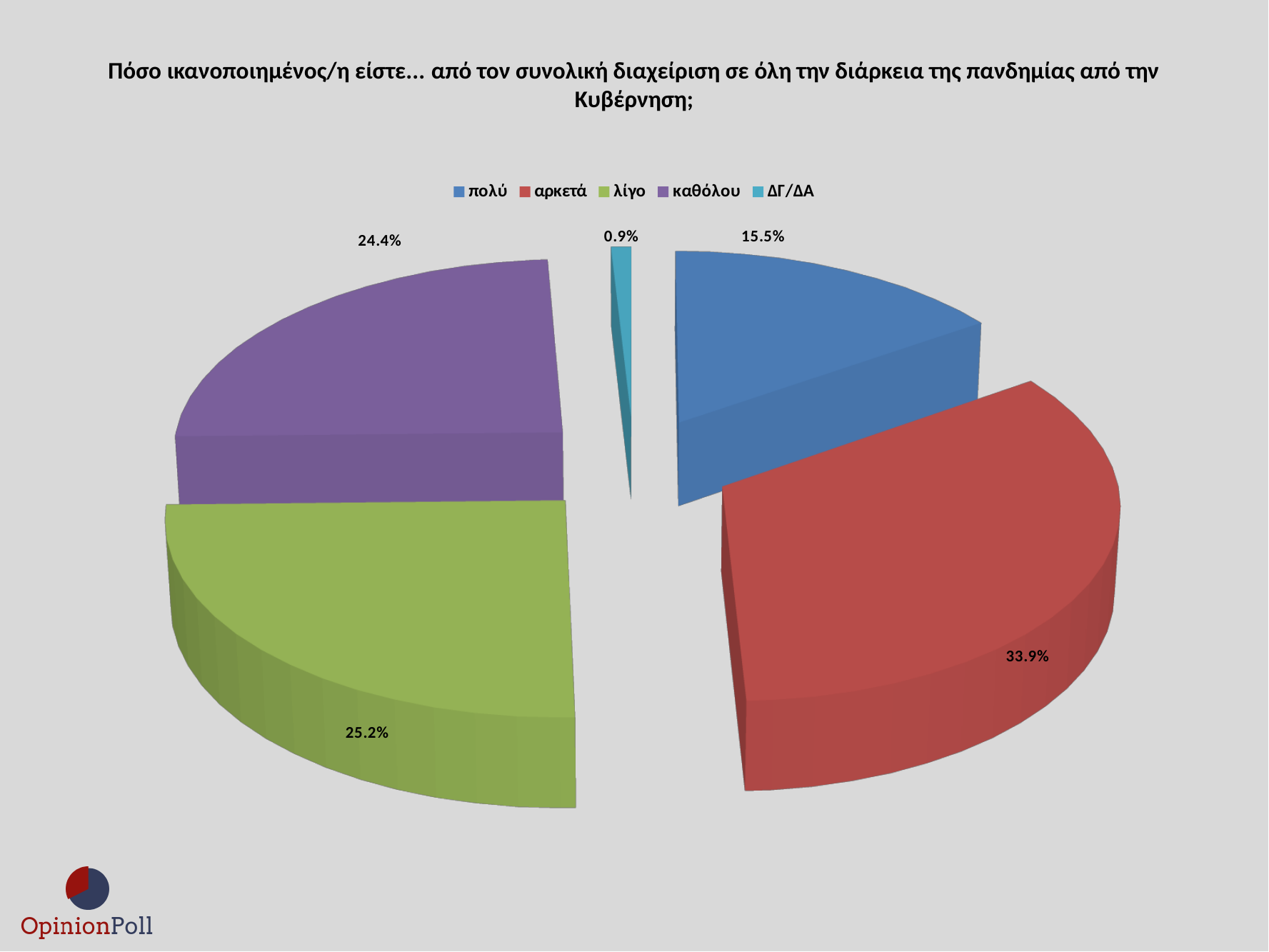
What kind of chart is shown on the slide? pie chart What percentage of respondents answered "ΔΓ/ΔΑ"? 0.9% What percentage of respondents answered "αρκετά"? 33.9% What percentage of respondents answered "πολύ"? 15.5% Which is larger, the share for "καθόλου" or the share for "πολύ"? καθόλου What is the difference in percentage points between "αρκετά" and "πολύ"? 18.4 What percentage of respondents answered "λίγο"? 25.2% How many categories does the legend list? 5 Which response category has the smallest share of the pie? ΔΓ/ΔΑ What is the difference in percentage points between "αρκετά" and "λίγο"? 8.7 What percentage of respondents answered "καθόλου"? 24.4% Which response category has the largest share of the pie? αρκετά